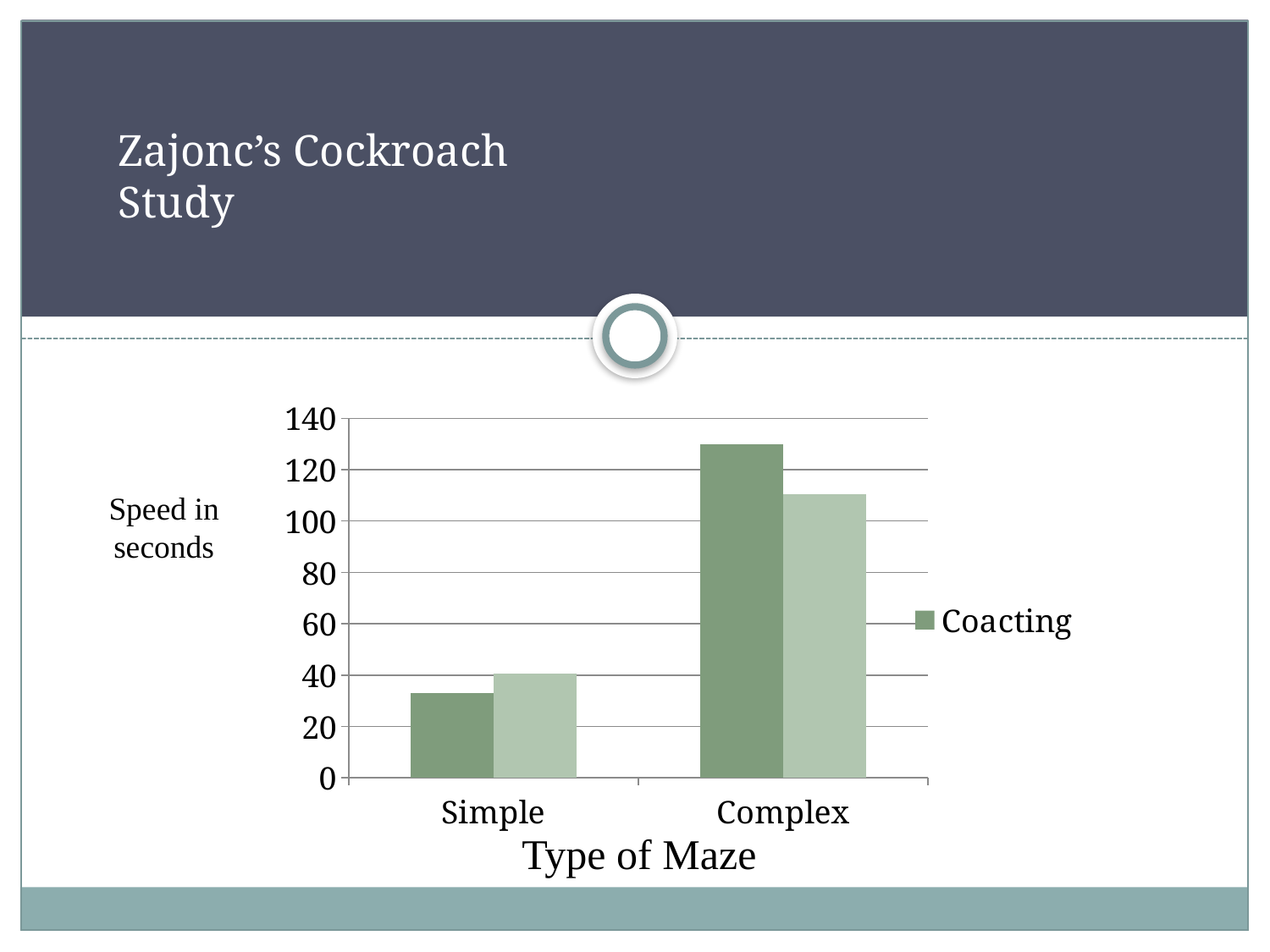
Which type of maze has the lower Coacting value? Simple How many categories are shown on the x axis of the chart? 2 What is the label of the x axis of the chart? Type of Maze Which type of maze has the higher Coacting value? Complex Is the Coacting value for Complex greater or less than 120? greater Is the Coacting value for Complex greater or less than 100? greater Is the Coacting value larger for Simple or for Complex? Complex How many series does the chart's legend list? 1 What is the label of the vertical axis of the chart? Speed in seconds Is the Coacting value for Simple greater or less than 40? less What kind of chart is shown on the slide? bar chart Do the Coacting values rise or fall from Simple to Complex along the x axis? rise